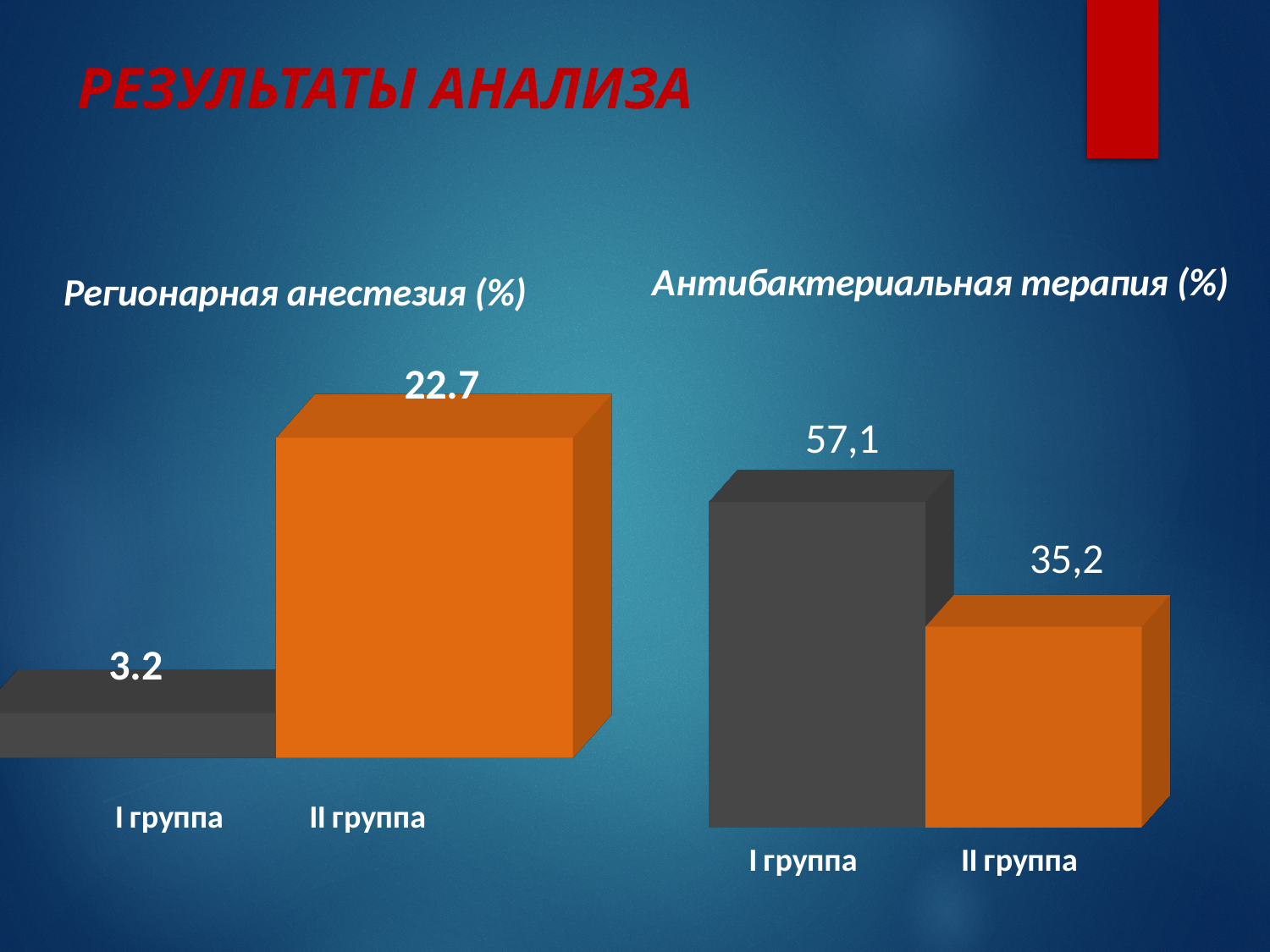
How many categories are shown in the 'Регионарная анестезия (%)' chart? 2 In the 'Антибактериальная терапия (%)' chart, what is the value for I группа? 57,1 What kind of chart is the 'Антибактериальная терапия (%)' chart? bar chart In the 'Регионарная анестезия (%)' chart, what is the value for I группа? 3.2 What is the title of the chart on the left side of the slide? Регионарная анестезия (%) In the 'Антибактериальная терапия (%)' chart, what is the difference between the values for I группа and II группа? 21,9 In the 'Регионарная анестезия (%)' chart, which group has the higher value? II группа In the 'Антибактериальная терапия (%)' chart, is the value for I группа larger or smaller than the value for II группа? larger In the 'Антибактериальная терапия (%)' chart, what is the value for II группа? 35,2 In the 'Регионарная анестезия (%)' chart, what is the difference between the values for II группа and I группа? 19.5 In the 'Антибактериальная терапия (%)' chart, which group has the lower value? II группа In the 'Регионарная анестезия (%)' chart, what is the value for II группа? 22.7